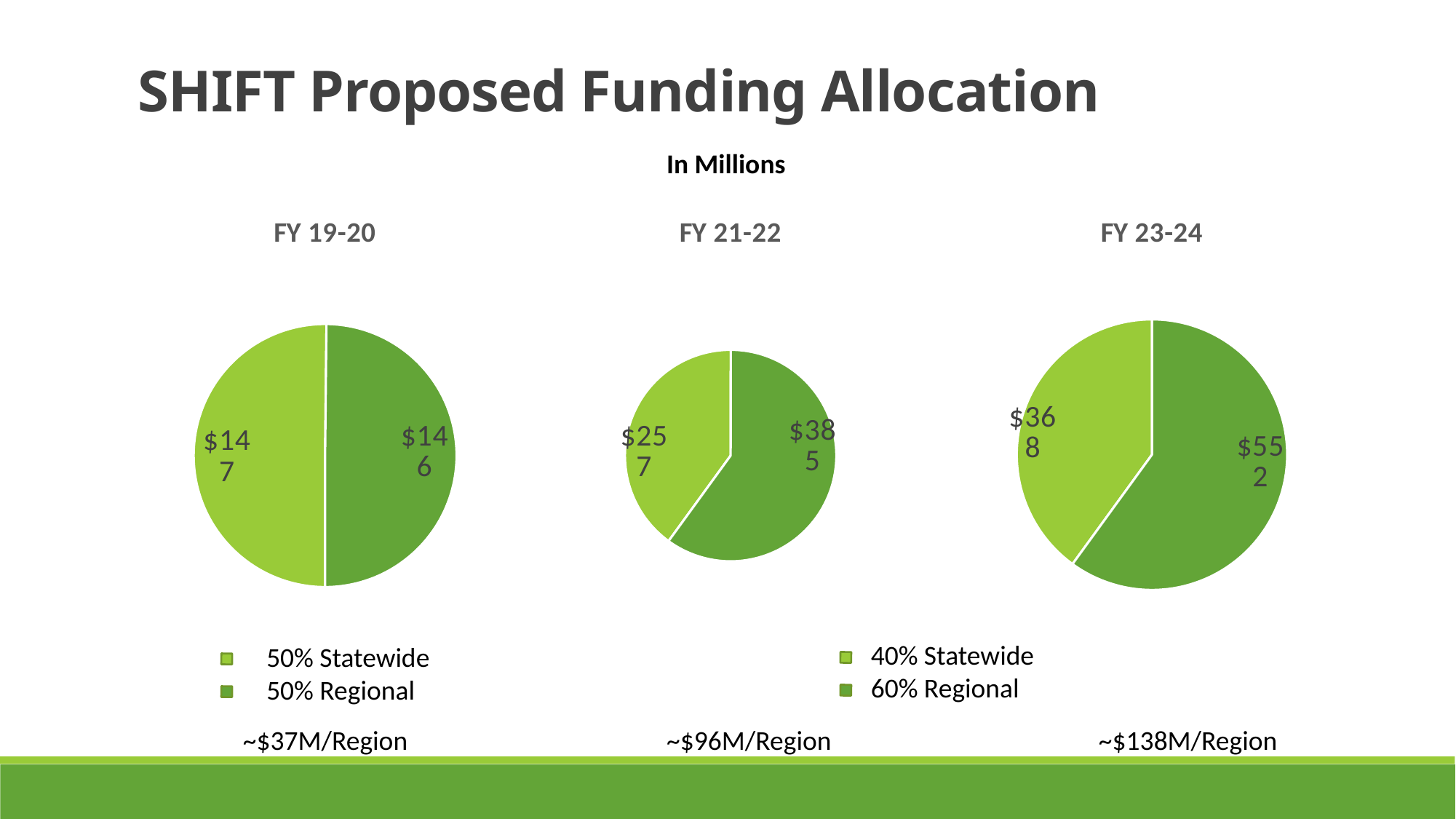
In the FY 23-24 pie chart, what is the value of the Regional slice? $552 How many pie charts are shown on the slide? 3 In the FY 19-20 pie chart, what is the value of the Statewide slice? $147 In the FY 23-24 pie chart, what is the difference between the Regional and Statewide values? $184 In the FY 21-22 pie chart, what is the value of the Regional slice? $385 In the FY 21-22 pie chart, what is the value of the Statewide slice? $257 In the FY 23-24 pie chart, what share of the total does the Regional slice represent? 60% In the FY 19-20 pie chart, what is the value of the Regional slice? $146 In the FY 23-24 pie chart, which slice is larger, Statewide or Regional? Regional What type of chart is used for FY 21-22? Pie chart In the FY 21-22 pie chart, what is the difference between the Regional and Statewide values? $128 In the FY 23-24 pie chart, what is the value of the Statewide slice? $368